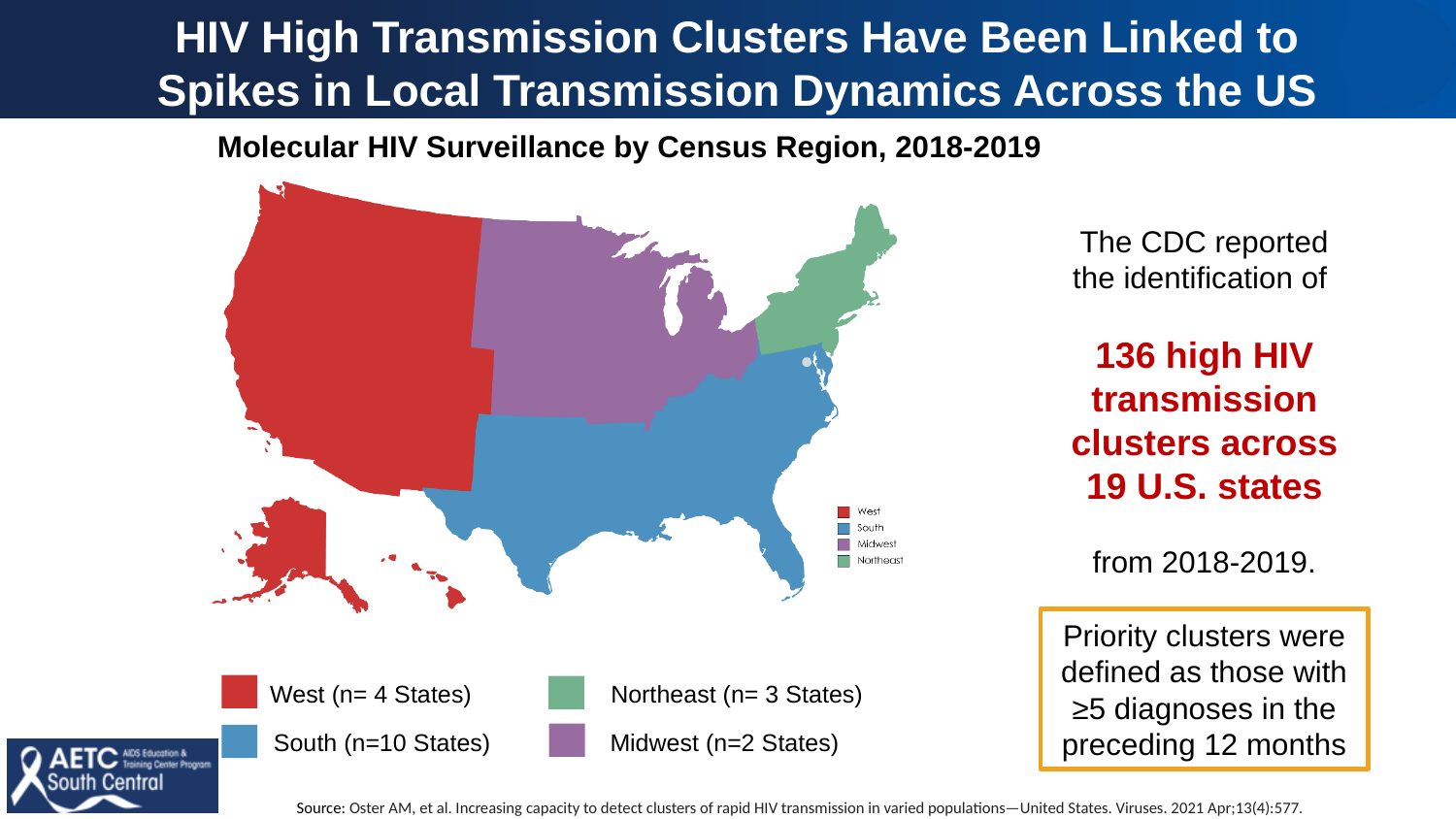
How many more states are in the South region than in the West region? 6 What is the total number of states across all four regions in the map legend? 19 Which census region has the smallest number of states in the map legend? Midwest What kind of chart is shown on the slide? Map According to the map legend, how many states are in the South region? 10 What colour represents the South region on the map? Blue According to the map legend, how many states are in the West region? 4 According to the map legend, how many states are in the Midwest region? 2 According to the map legend, how many states are in the Northeast region? 3 How many census regions are shown in the map legend? 4 Which census region has the largest number of states in the map legend? South Which region has more states, Northeast or Midwest? Northeast